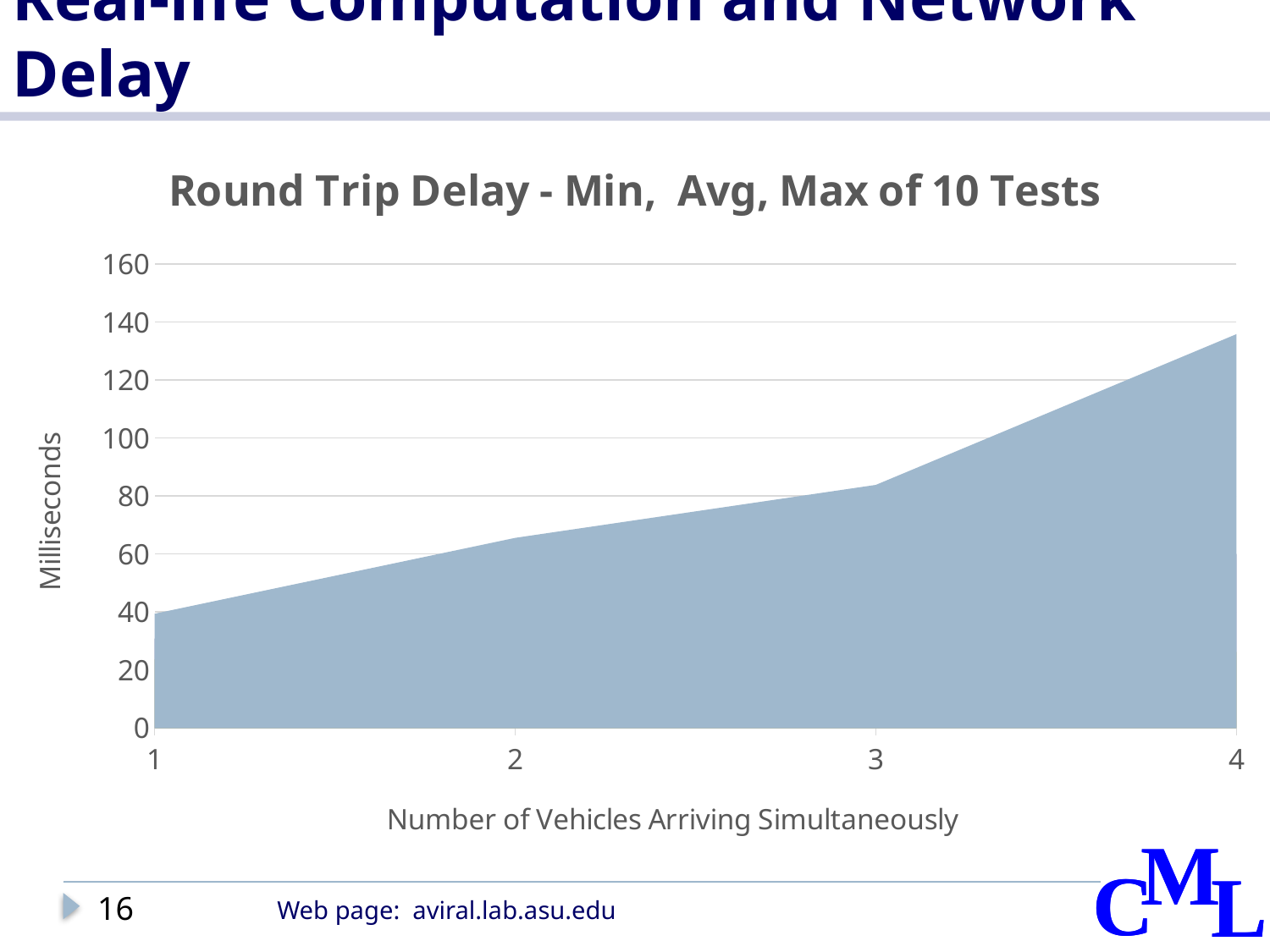
Is the round trip delay for 4 vehicles greater or less than 120 milliseconds? greater How many data points are plotted along the x axis? 4 Is the round trip delay for 1 vehicle greater or less than 60 milliseconds? less Is the round trip delay for 3 vehicles greater or less than 100 milliseconds? less What type of chart is shown on the slide? Area chart Does the round trip delay rise or fall as the number of vehicles arriving simultaneously increases? Rise What is the title of the chart? Round Trip Delay - Min, Avg, Max of 10 Tests What is the label of the vertical axis? Milliseconds Which number of vehicles arriving simultaneously has the lowest round trip delay? 1 Which number of vehicles arriving simultaneously has the highest round trip delay? 4 Which has a larger round trip delay, 2 vehicles or 4 vehicles arriving simultaneously? 4